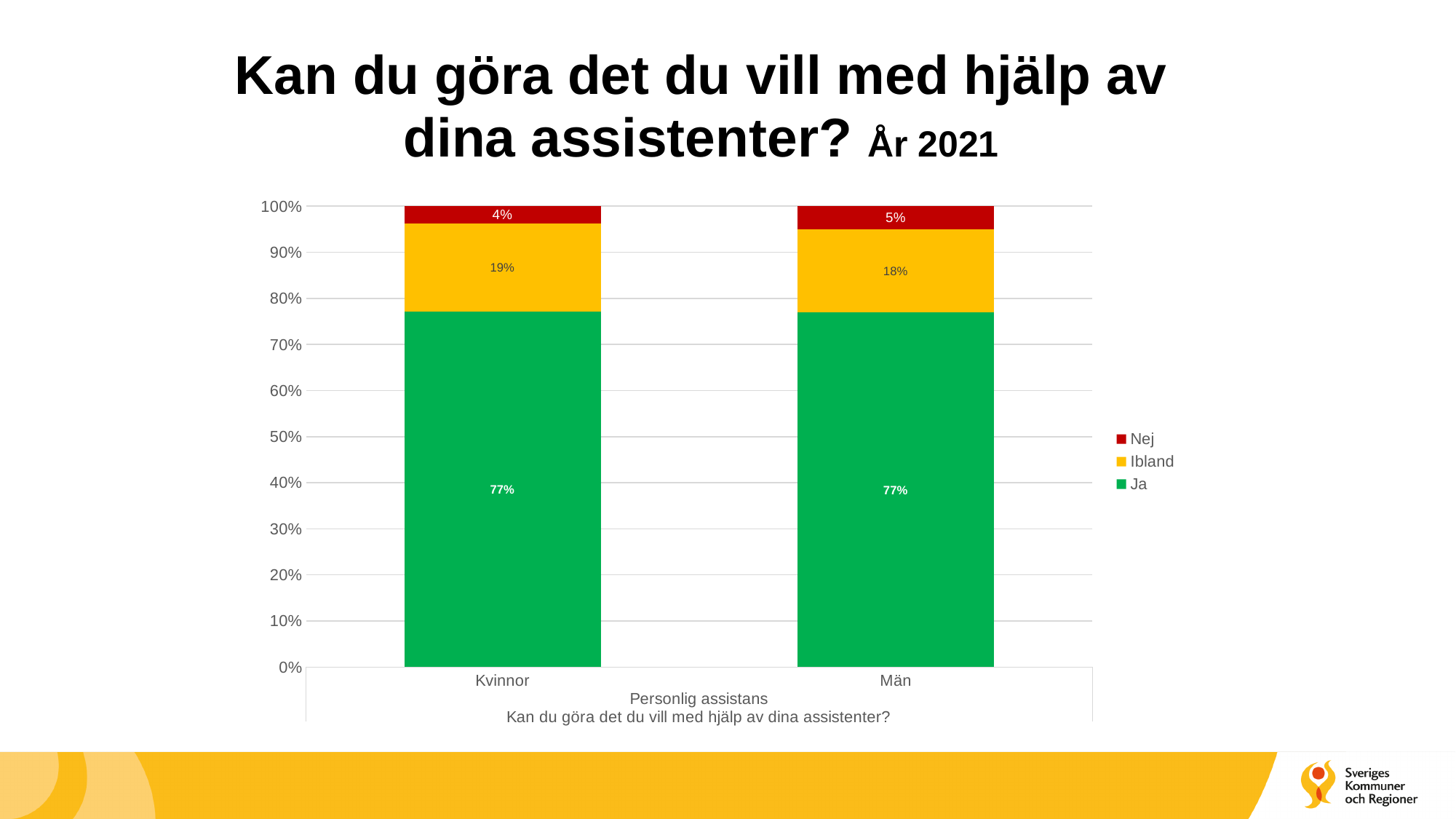
Which group has the larger Ibland share, Kvinnor or Män? Kvinnor How many series does the legend list? 3 How many categories are shown on the x axis? 2 What is the total of the stacked bar for Kvinnor? 100% What percentage of Kvinnor answered Ja? 77% What is the difference between the Ibland share for Kvinnor and for Män? 1% Which group has the larger Nej share, Kvinnor or Män? Män What percentage of Män answered Nej? 5% What kind of chart is shown on the slide? Stacked bar chart Which colour represents the Ja series in the legend? Green What percentage of Män answered Ibland? 18% What percentage of Kvinnor answered Nej? 4%